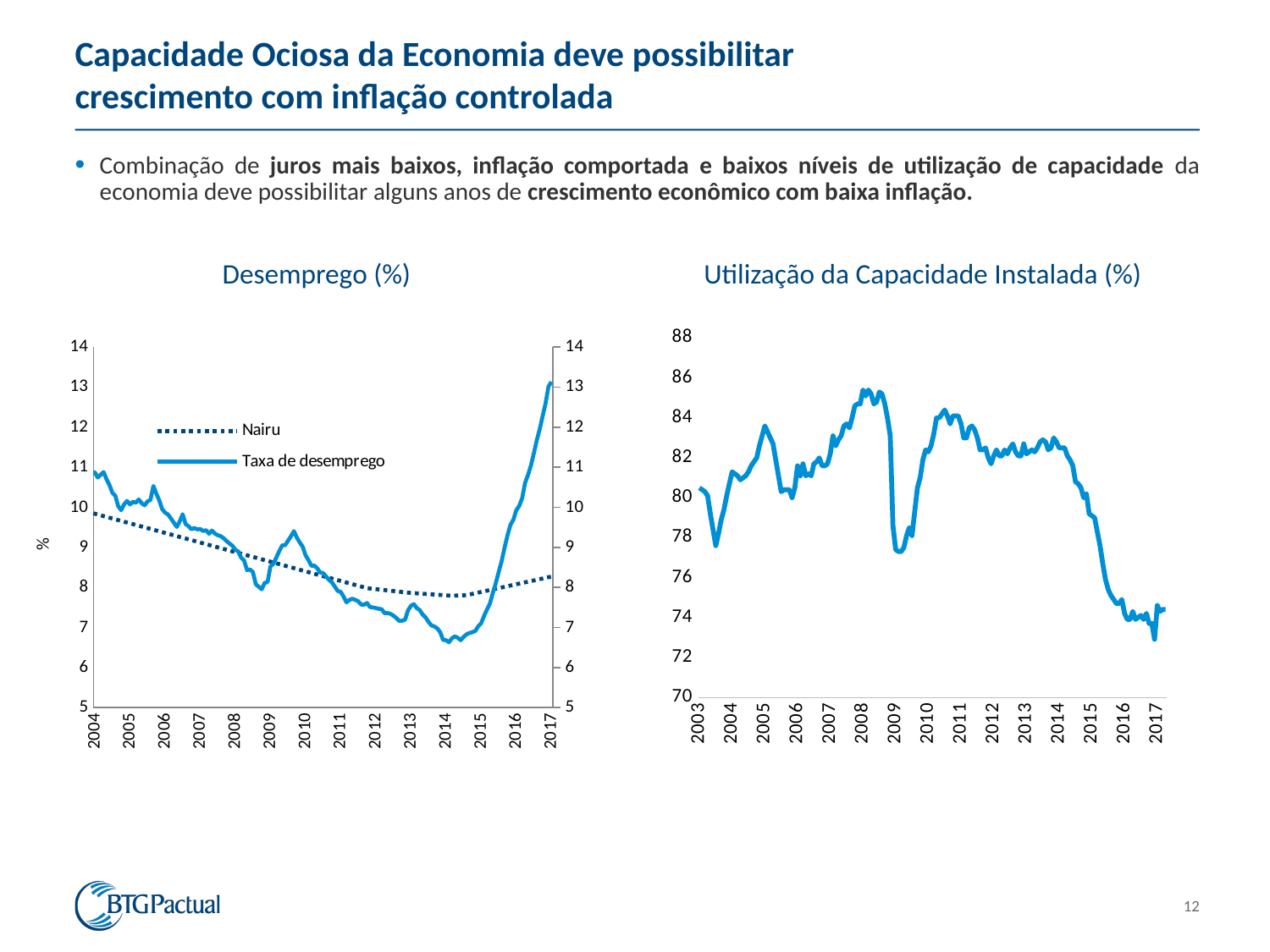
In the 'Desemprego (%)' chart, is the value of 'Taxa de desemprego' at 2014 greater or less than 7? less What is the title of the chart on the right side of the slide? Utilização da Capacidade Instalada (%) In the 'Desemprego (%)' chart, is the value of 'Taxa de desemprego' at 2017 greater or less than 12? greater What kind of chart is the 'Utilização da Capacidade Instalada (%)' chart on the right? line chart What kind of chart is the 'Desemprego (%)' chart on the left? line chart In the 'Desemprego (%)' chart, how many series does the legend list? 2 In the 'Utilização da Capacidade Instalada (%)' chart, is the value at 2017 greater or less than 76? less In the 'Utilização da Capacidade Instalada (%)' chart, does the value rise or fall between 2014 and 2016? fall In the 'Desemprego (%)' chart, does 'Taxa de desemprego' rise or fall between 2015 and 2017? rise In the 'Desemprego (%)' chart, which series is drawn with a dotted line? Nairu